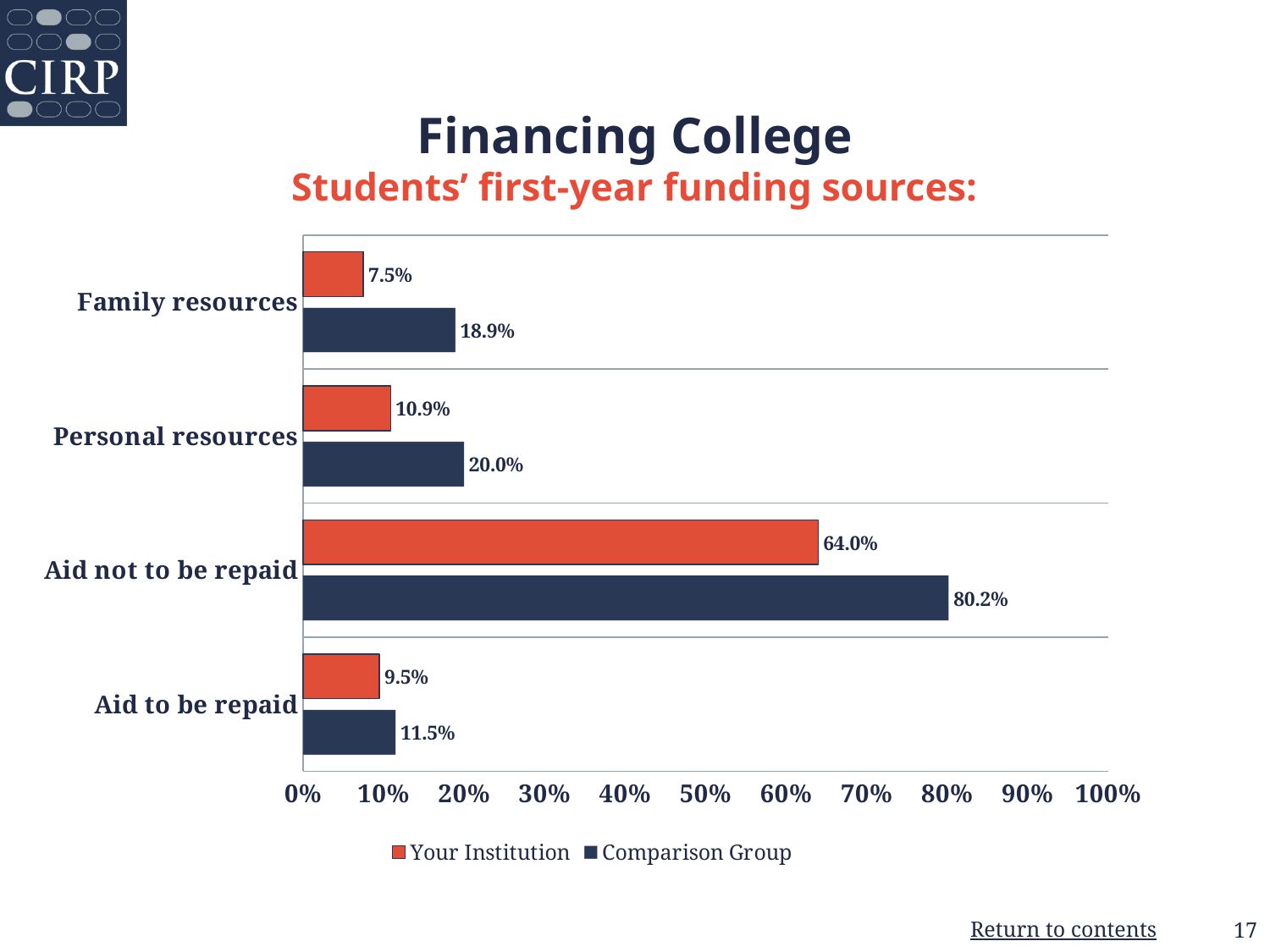
What is the value for Comparison Group for Personal resources? 20.0% What kind of chart is shown on the slide? Bar chart Which is larger for Family resources: Your Institution or Comparison Group? Comparison Group What is the difference between the Comparison Group and Your Institution values for Aid not to be repaid? 16.2% What is the value for Comparison Group for Aid not to be repaid? 80.2% What colour represents Your Institution in the chart? Orange-red What is the value for Your Institution for Aid to be repaid? 9.5% Which category has the lowest value for Comparison Group? Aid to be repaid How many series does the legend list? 2 What is the value for Your Institution for Family resources? 7.5% Which category has the highest value for Your Institution? Aid not to be repaid How many categories are shown on the chart? 4